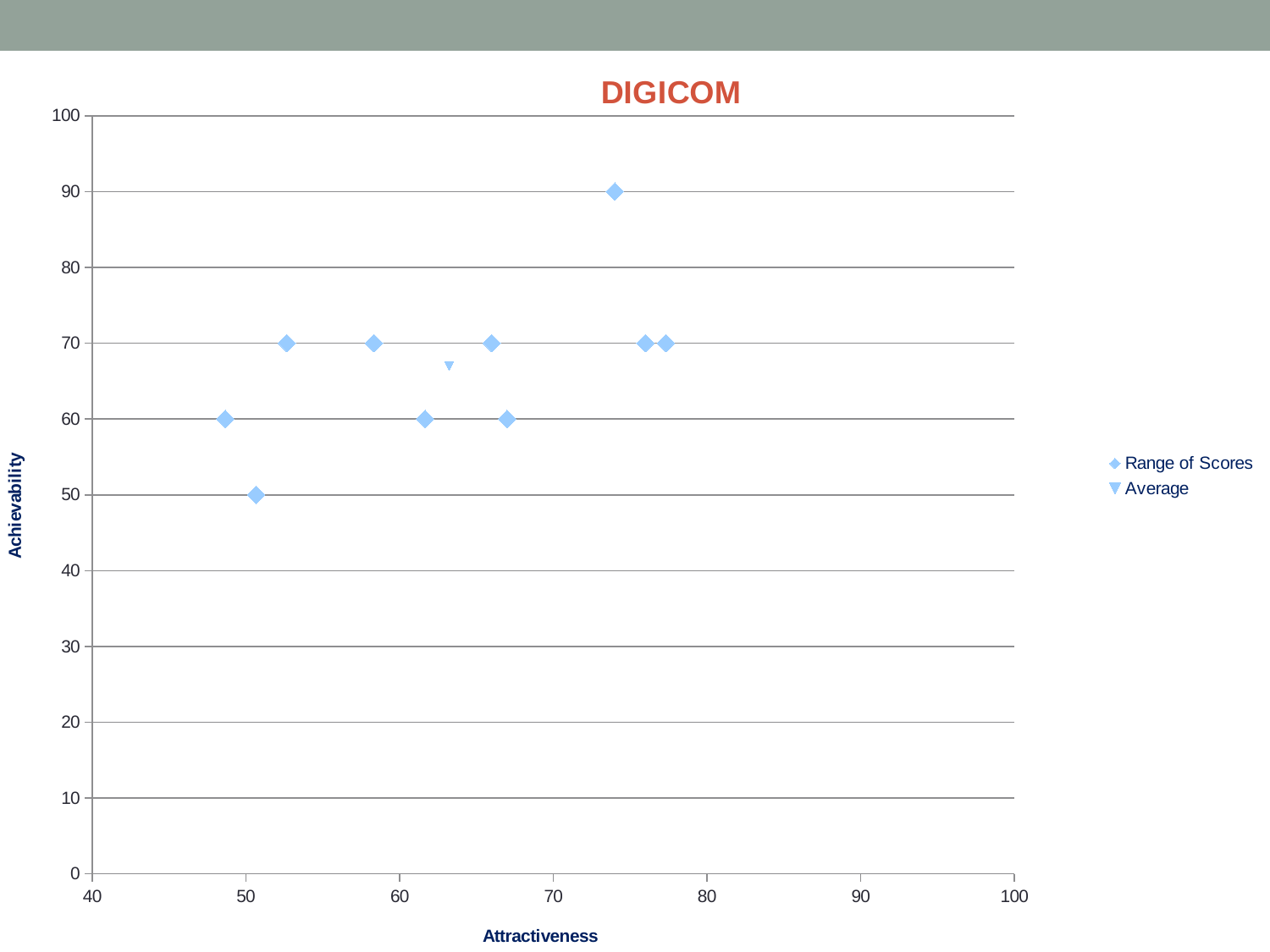
How many points are plotted for the Range of Scores series? 10 How many series does the legend list? 2 Is the Attractiveness value of the point with Achievability 90 greater or less than 70? greater How many Range of Scores points have an Achievability of 70? 5 What is the lowest Achievability value among the Range of Scores points? 50 Is the Attractiveness value of the point with Achievability 50 greater or less than 60? less What kind of chart is shown on the slide? scatter chart What is the label of the horizontal axis? Attractiveness Is the Achievability value of the Average point greater or less than 60? greater What is the highest Achievability value among the Range of Scores points? 90 What is the title of the chart? DIGICOM